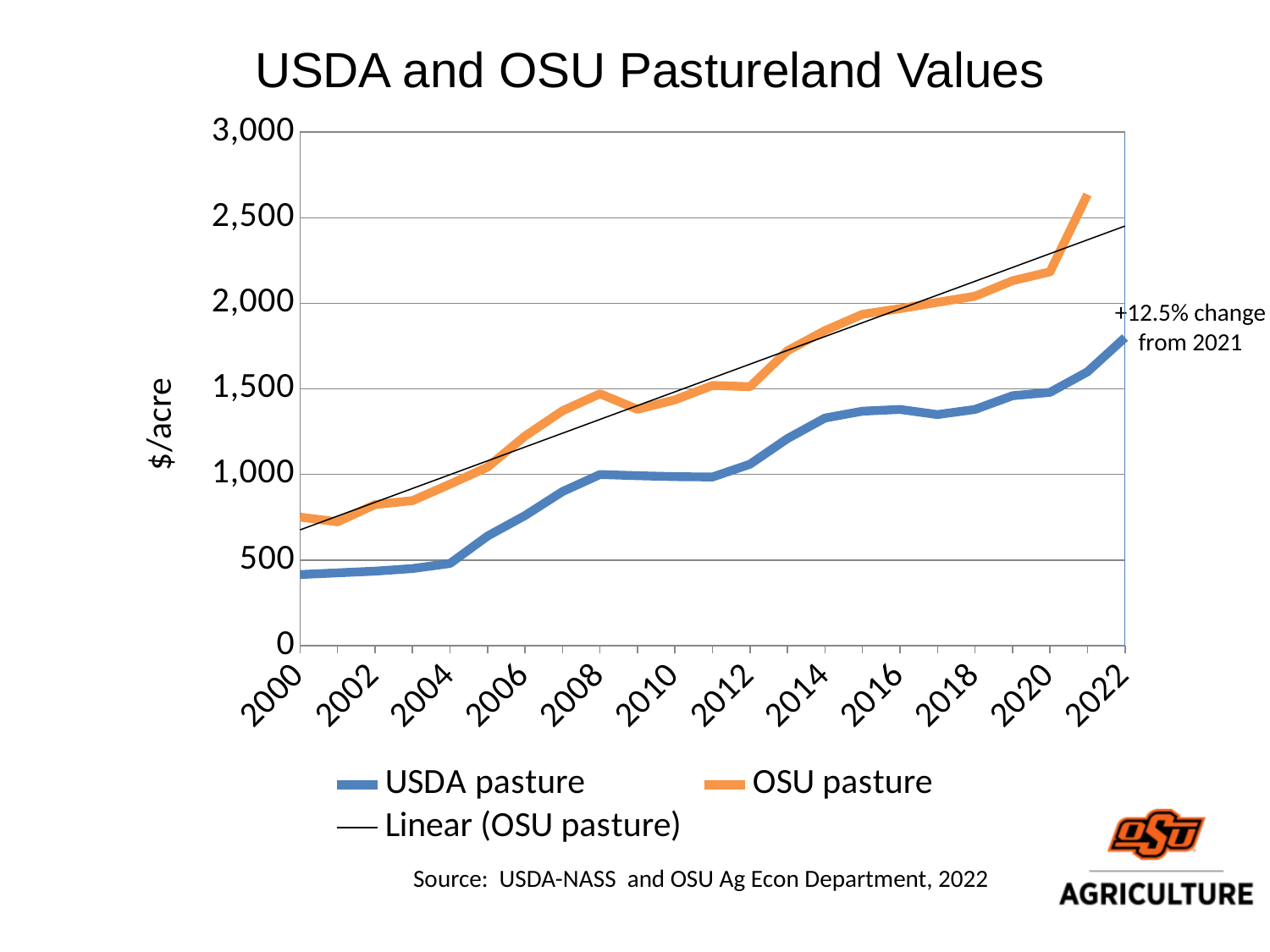
How many entries does the legend list? 3 Is the value for USDA pasture in 2022 greater or less than 1,500? greater What is the title of the chart? USDA and OSU Pastureland Values What is the label on the vertical axis? $/acre What percentage change from 2021 is annotated on the chart? +12.5% Is the value for OSU pasture in 2004 greater or less than 1,000? less What kind of chart is shown on the slide? line chart Do the USDA pasture values generally rise or fall from 2000 to 2022? rise In 2010, which series has the higher value, USDA pasture or OSU pasture? OSU pasture Is the value for OSU pasture in 2021 greater or less than 2,500? greater